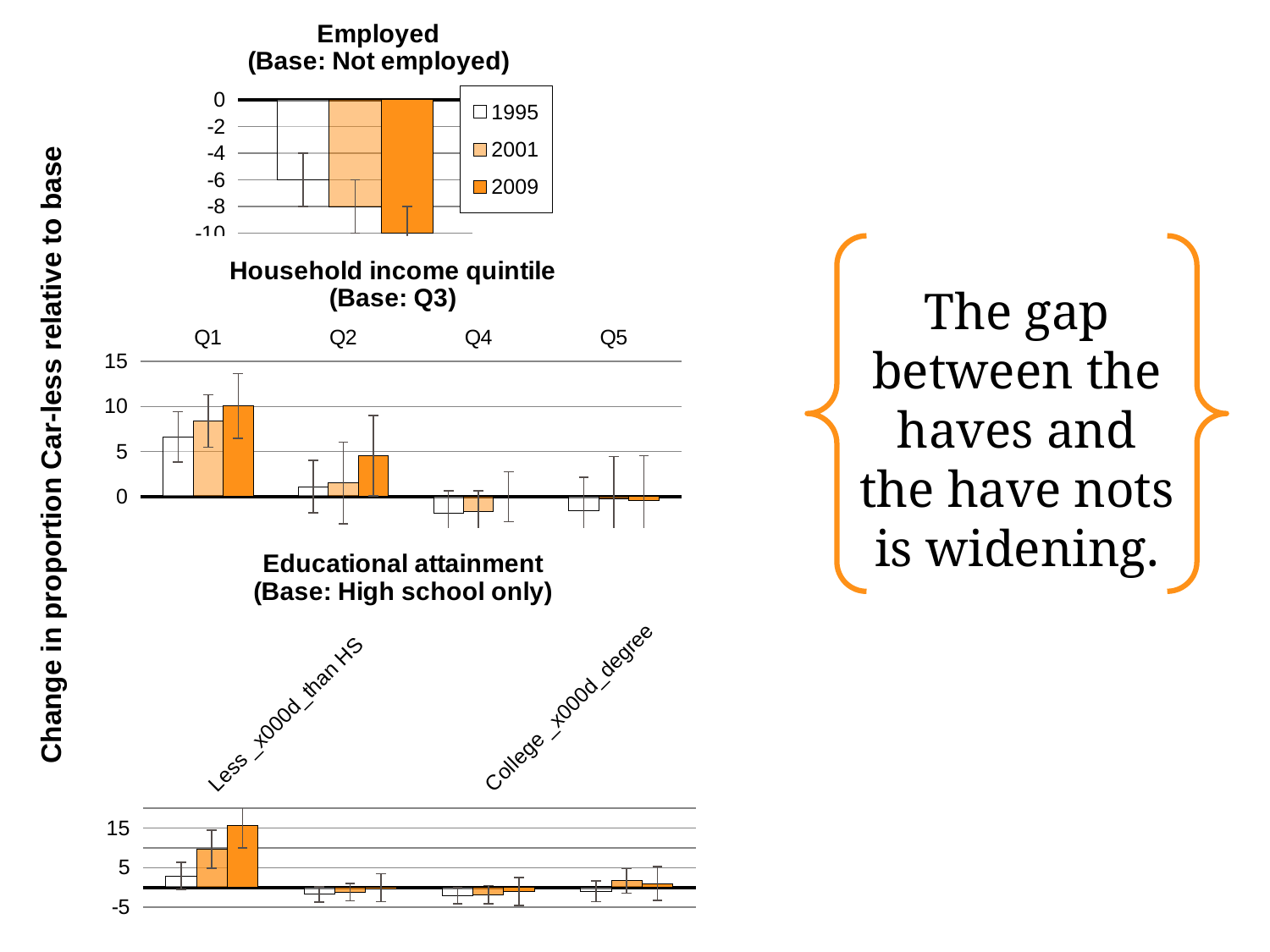
In the 'Employed (Base: Not employed)' chart, do the values rise or fall from 1995 to 2009? fall In the 'Household income quintile (Base: Q3)' chart, which quintile has the highest values? Q1 In the 'Employed (Base: Not employed)' chart, is the value for 2009 greater or less than -8? less In the 'Household income quintile (Base: Q3)' chart, is the 2009 value for Q1 larger or smaller than the 2009 value for Q4? larger What is the base category named in the title of the 'Household income quintile' chart? Q3 In the 'Educational attainment (Base: High school only)' chart, is the 2009 value for 'Less than HS' greater or less than 5? greater In the 'Employed (Base: Not employed)' chart, is the value for 1995 greater or less than -8? greater In the 'Employed (Base: Not employed)' chart, which year has the lowest value? 2009 How many income quintile categories are shown on the 'Household income quintile (Base: Q3)' chart? 4 What kind of chart is the 'Employed (Base: Not employed)' chart? bar chart How many series does the legend on the 'Employed (Base: Not employed)' chart list? 3